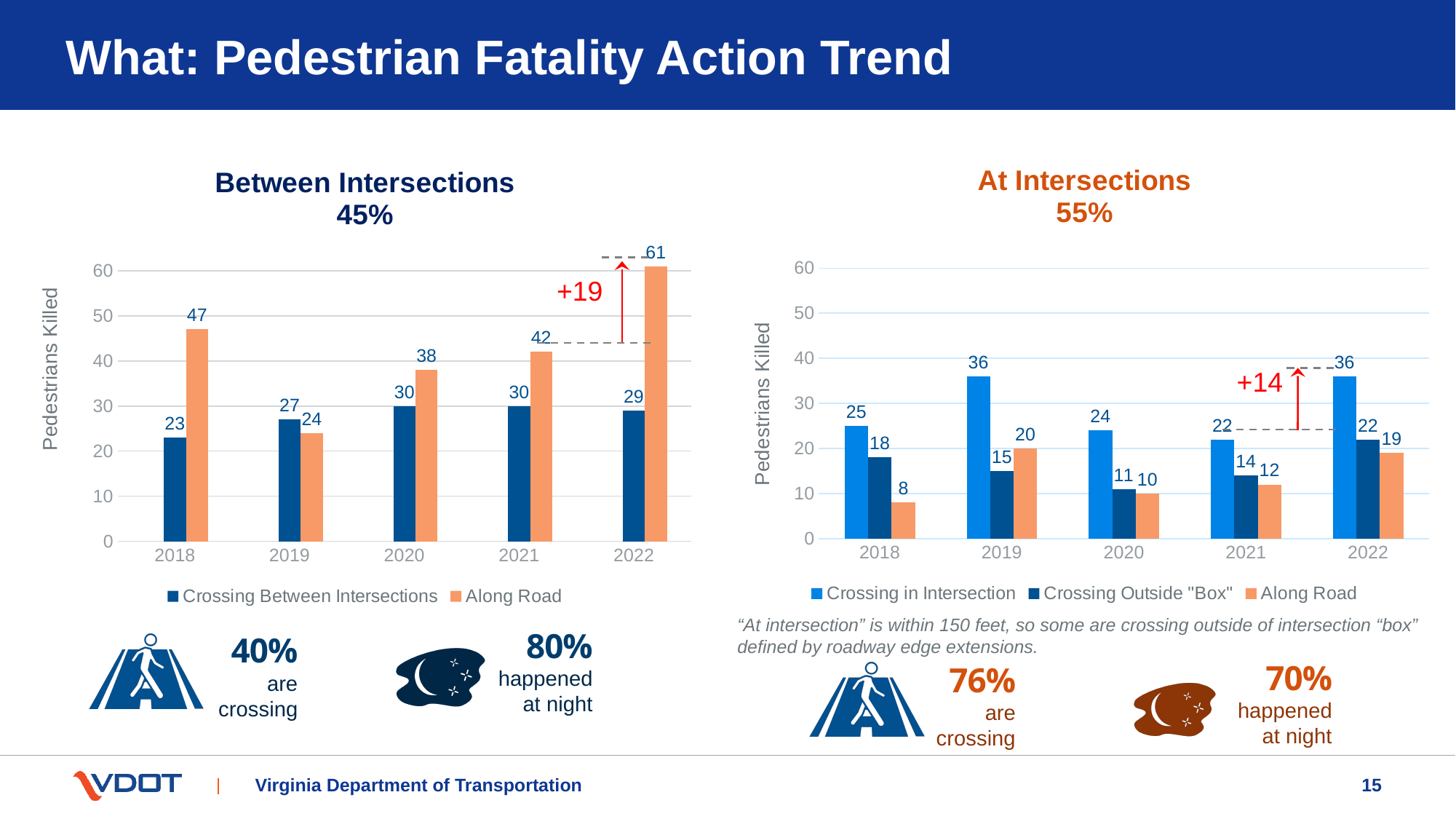
In the 'Between Intersections' chart, which year has the highest Along Road value? 2022 In the 'Between Intersections' chart, how many series does the legend list? 2 In the 'Between Intersections' chart, what is the value for Along Road in 2022? 61 In the 'At Intersections' chart, which year has the lowest Crossing Outside "Box" value? 2020 In the 'Between Intersections' chart, what is the value for Crossing Between Intersections in 2019? 27 In the 'At Intersections' chart, how many series does the legend list? 3 What type of chart is the 'At Intersections' chart? Bar chart In the 'Between Intersections' chart, what is the difference between the Along Road values for 2022 and 2021? 19 In the 'At Intersections' chart, what is the value for Along Road in 2018? 8 In the 'At Intersections' chart, what is the value for Crossing in Intersection in 2019? 36 In the 'Between Intersections' chart, which year has the lowest Along Road value? 2019 In the 'At Intersections' chart, which is larger in 2021: Crossing in Intersection or Along Road? Crossing in Intersection